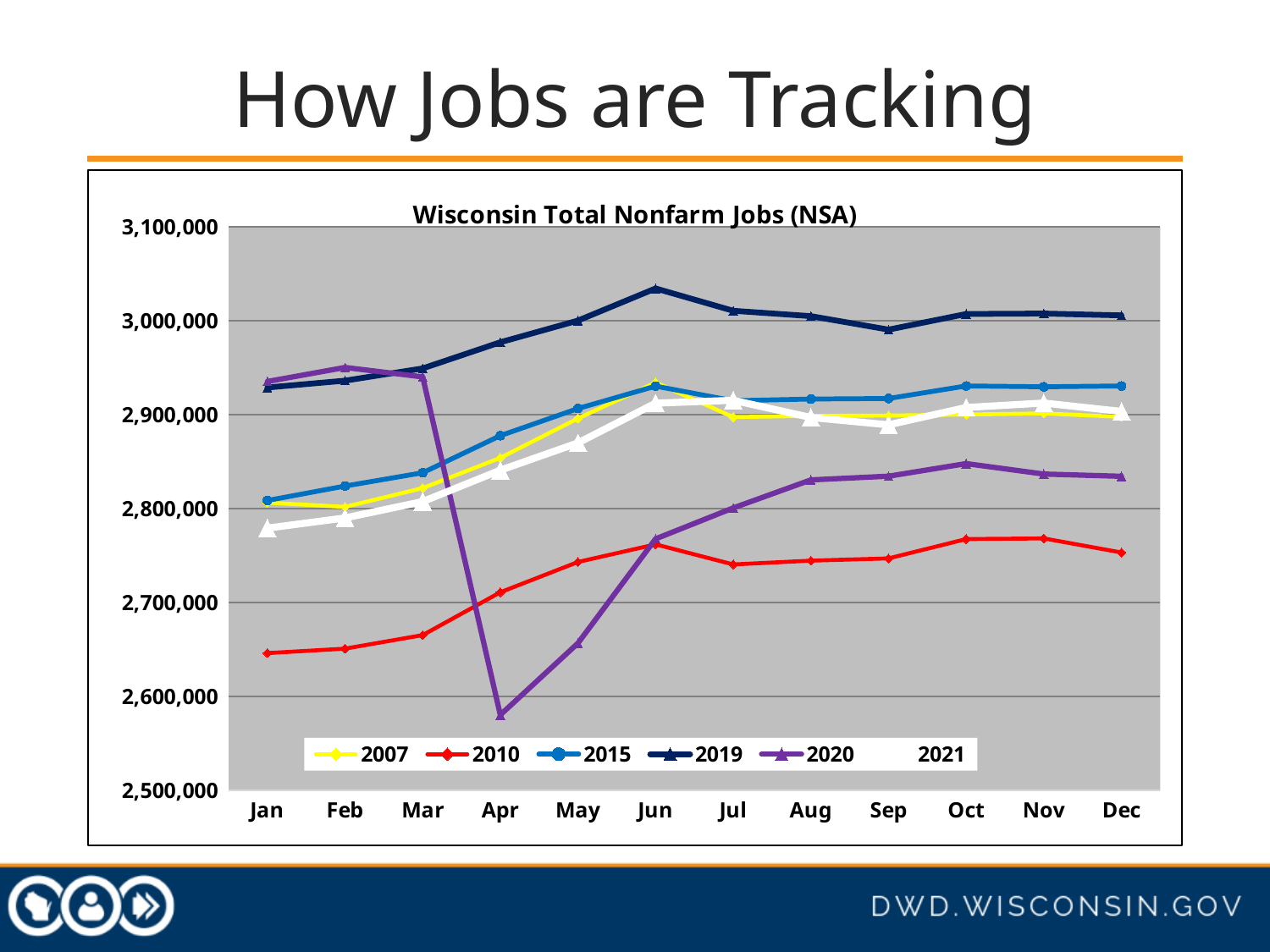
Is the value for 2010 in Jan greater or less than 2,700,000? less In Dec, which is larger: the value for 2020 or the value for 2021? 2021 What is the title of the chart? Wisconsin Total Nonfarm Jobs (NSA) Which year has the highest value in Jun? 2019 Is the value for 2021 in Jan greater or less than 2,800,000? less Is the value for 2019 in Jun greater or less than 3,000,000? greater What kind of chart is shown on the slide? line chart How many series does the legend list? 6 Which year has the lowest value in Apr? 2020 Does the 2020 line rise or fall from Apr to Oct? rise How many months are shown along the x axis? 12